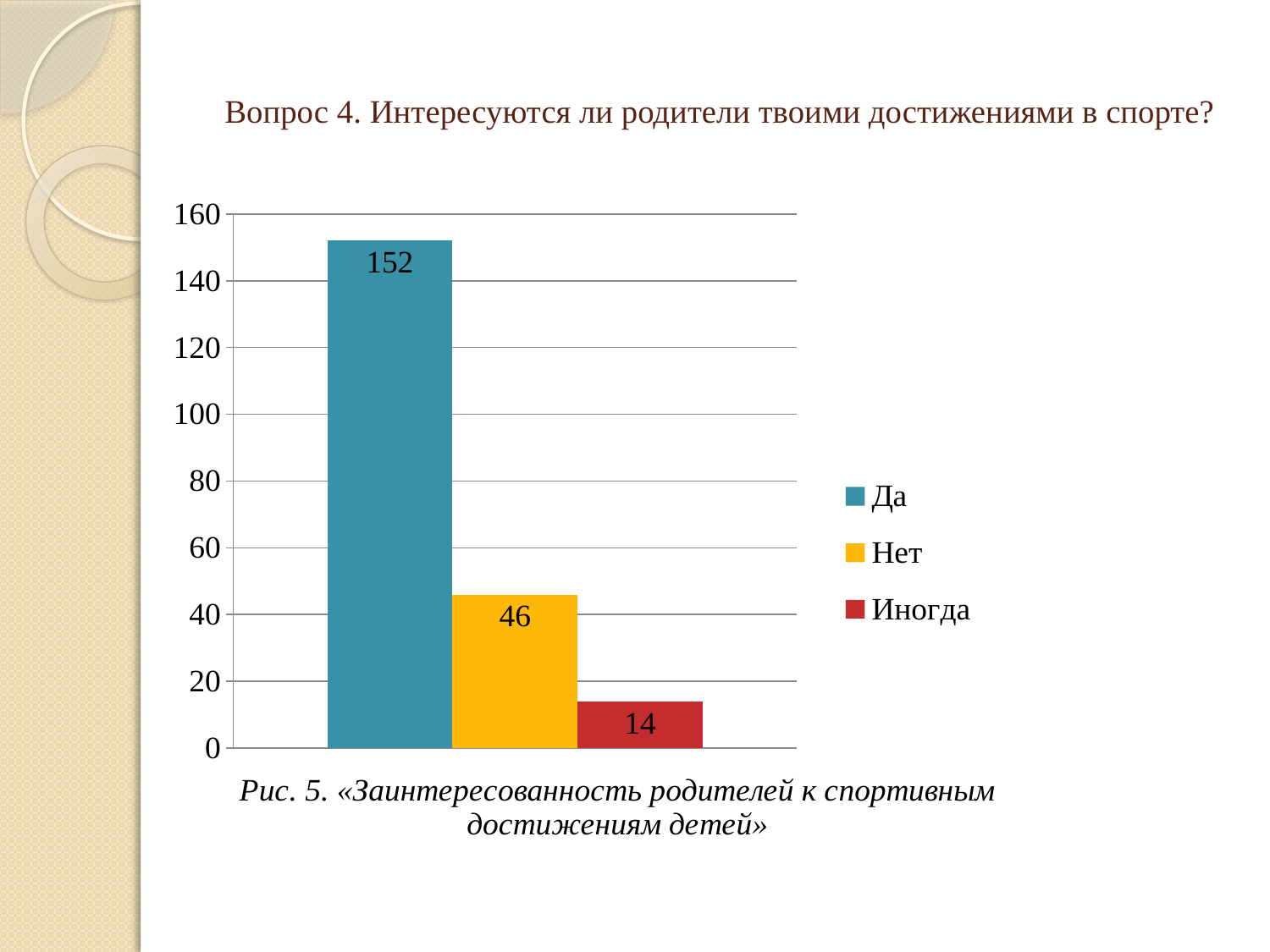
Which is larger, the value for "Нет" or the value for "Иногда"? Нет What colour is the bar for "Нет"? yellow What is the value for "Иногда"? 14 What is the difference between the values for "Да" and "Нет"? 106 Is the value for "Да" greater or less than 140? greater What is the value for "Нет"? 46 What is the value for "Да"? 152 Which category has the lowest value? Иногда Which category has the highest value? Да What kind of chart is shown on the slide? bar chart How many series does the legend list? 3 What is the difference between the values for "Нет" and "Иногда"? 32